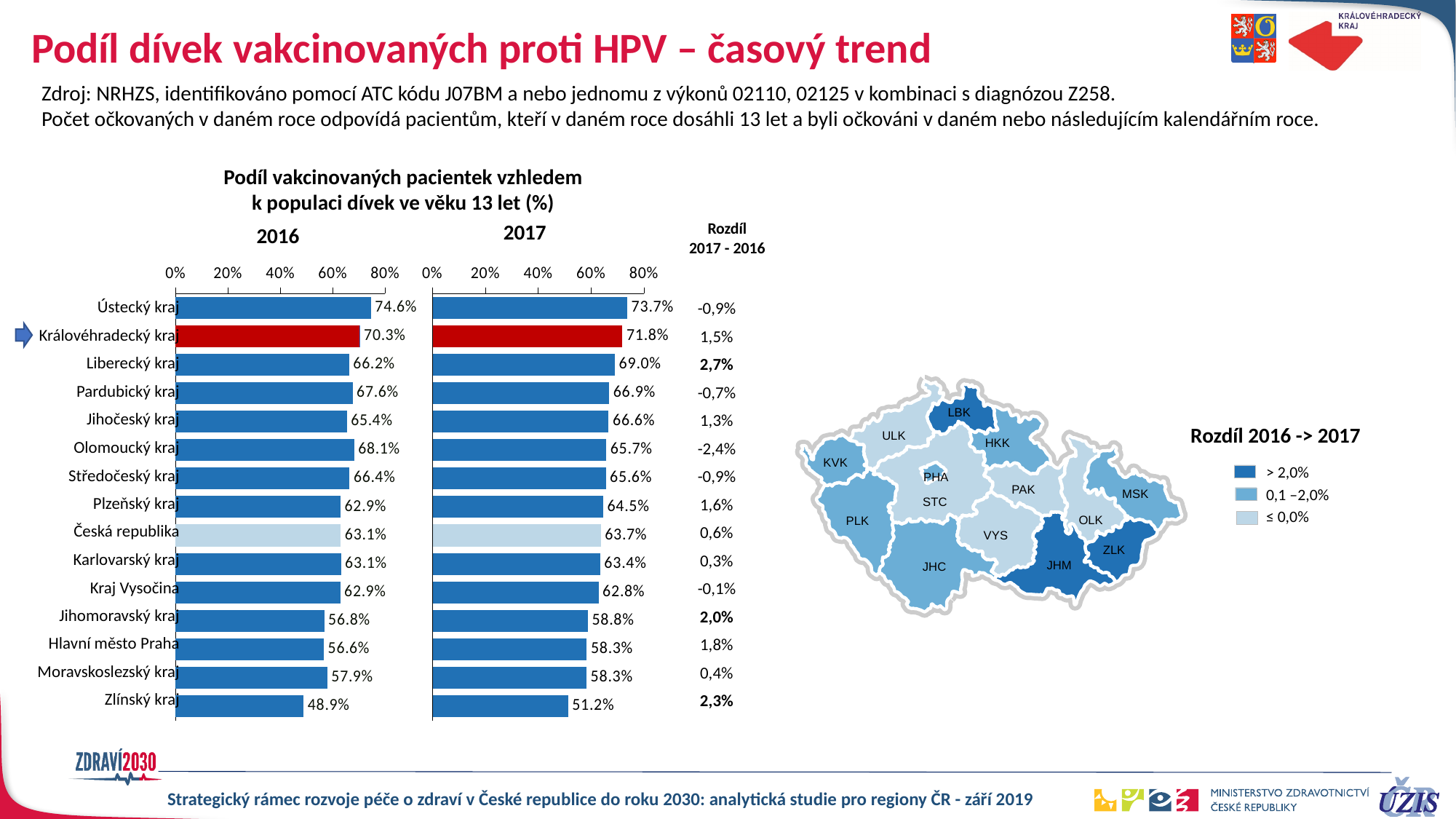
In the 2017 chart, which category has the lowest value? Zlínský kraj In the 2017 chart, what is the value for Česká republika? 63.7% In the 2016 chart, which category has the highest value? Ústecký kraj How many categories are shown in the 2016 chart? 15 What kind of chart is used to show the 2016 and 2017 values? bar chart Which category's bar is highlighted in red in both the 2016 and 2017 charts? Královéhradecký kraj What is the difference between the 2017 and 2016 values for Zlínský kraj? 2.3% In the 2016 chart, what is the value for Královéhradecký kraj? 70.3% Which is larger: the 2016 value for Olomoucký kraj or the 2016 value for Pardubický kraj? Olomoucký kraj In the 2016 chart, is the value for Zlínský kraj greater or less than 60%? less What is the value shown in the 'Rozdíl 2017 - 2016' column for Olomoucký kraj? -2,4% In the 2017 chart, what is the value for Liberecký kraj? 69.0%